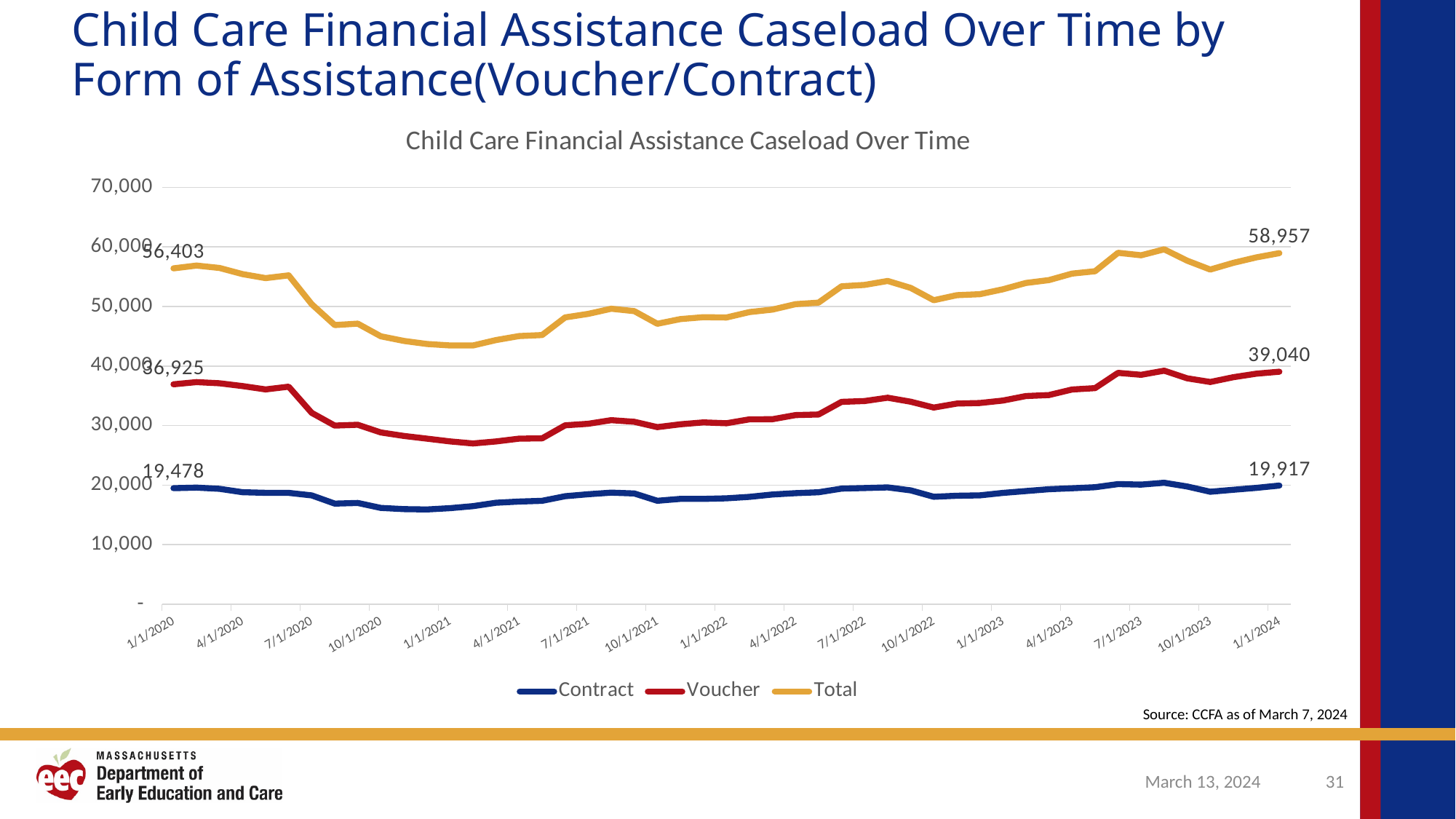
What is the Voucher caseload value labelled at 1/1/2020? 36,925 What type of chart is shown on the slide? line chart How many series does the legend list? 3 What is the difference between the Voucher values labelled at 1/1/2024 and 1/1/2020? 2,115 What is the Total caseload value labelled at 1/1/2024? 58,957 Which series has the lowest values throughout the chart? Contract What is the Contract caseload value labelled at 1/1/2024? 19,917 Which is larger at 1/1/2024: the Voucher value or the Contract value? Voucher Is the Voucher value at 1/1/2021 greater or less than 30,000? less What is the title of the chart? Child Care Financial Assistance Caseload Over Time What is the Total caseload value labelled at 1/1/2020? 56,403 What is the difference between the Total values labelled at 1/1/2024 and 1/1/2020? 2,554